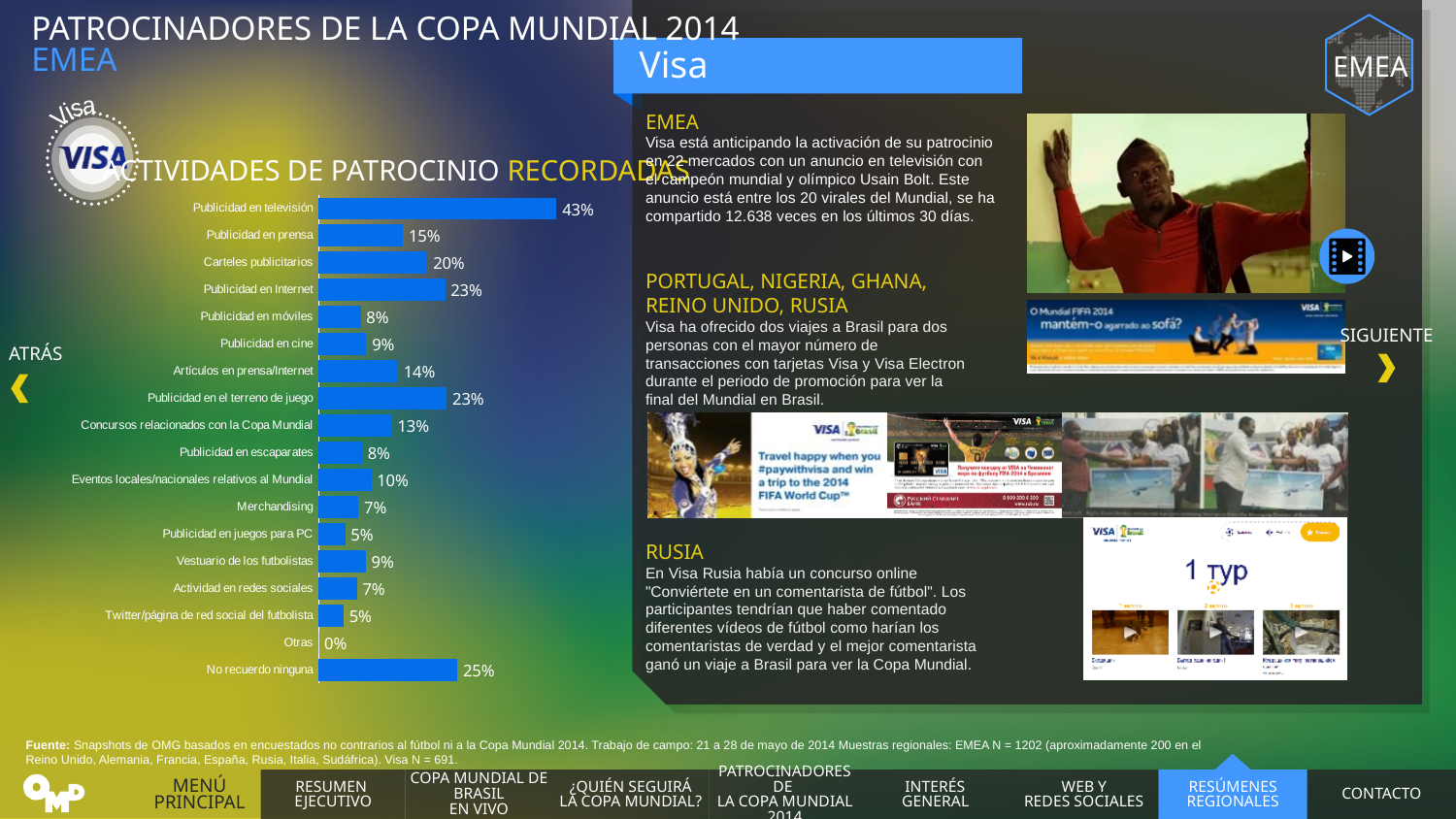
What kind of chart is shown on the slide? Bar chart What is the difference between Publicidad en televisión and Publicidad en Internet? 20% Which is larger, Publicidad en prensa or Carteles publicitarios? Carteles publicitarios What value is shown for No recuerdo ninguna? 25% What value is shown for Publicidad en televisión? 43% Which category has the highest value? Publicidad en televisión Which is larger, Concursos relacionados con la Copa Mundial or Publicidad en escaparates? Concursos relacionados con la Copa Mundial Which category has the lowest value? Otras What is the title of the chart? ACTIVIDADES DE PATROCINIO RECORDADAS What value is shown for Carteles publicitarios? 20% How many categories are shown in the chart? 18 What value is shown for Merchandising? 7%